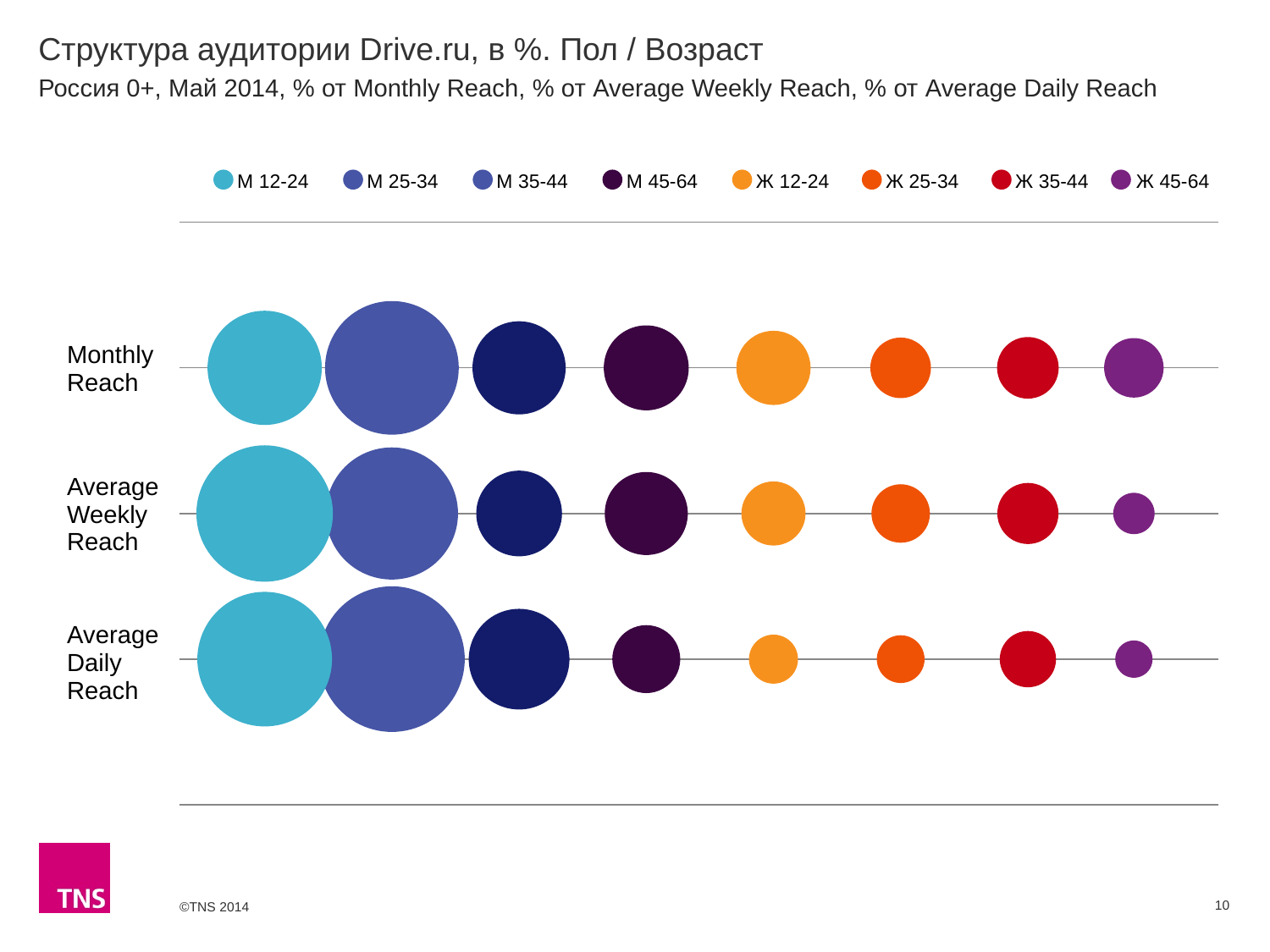
What is the title of the chart on the slide? Структура аудитории Drive.ru, в %. Пол / Возраст Does the Ж 45-64 bubble get larger or smaller going from Monthly Reach to Average Daily Reach? smaller Does the М 12-24 bubble get larger or smaller going from Monthly Reach to Average Daily Reach? larger How many series does the legend list? 8 In the Average Daily Reach row, which bubble is larger: М 35-44 or М 45-64? М 35-44 In the Monthly Reach row, which group has the largest bubble? М 25-34 In the Monthly Reach row, which bubble is larger: М 25-34 or Ж 45-64? М 25-34 How many reach categories (rows) are plotted on the chart? 3 In the Average Weekly Reach row, which bubble is larger: М 12-24 or Ж 12-24? М 12-24 What kind of chart is shown on the slide? bubble chart In the Average Daily Reach row, which group has the smallest bubble? Ж 45-64